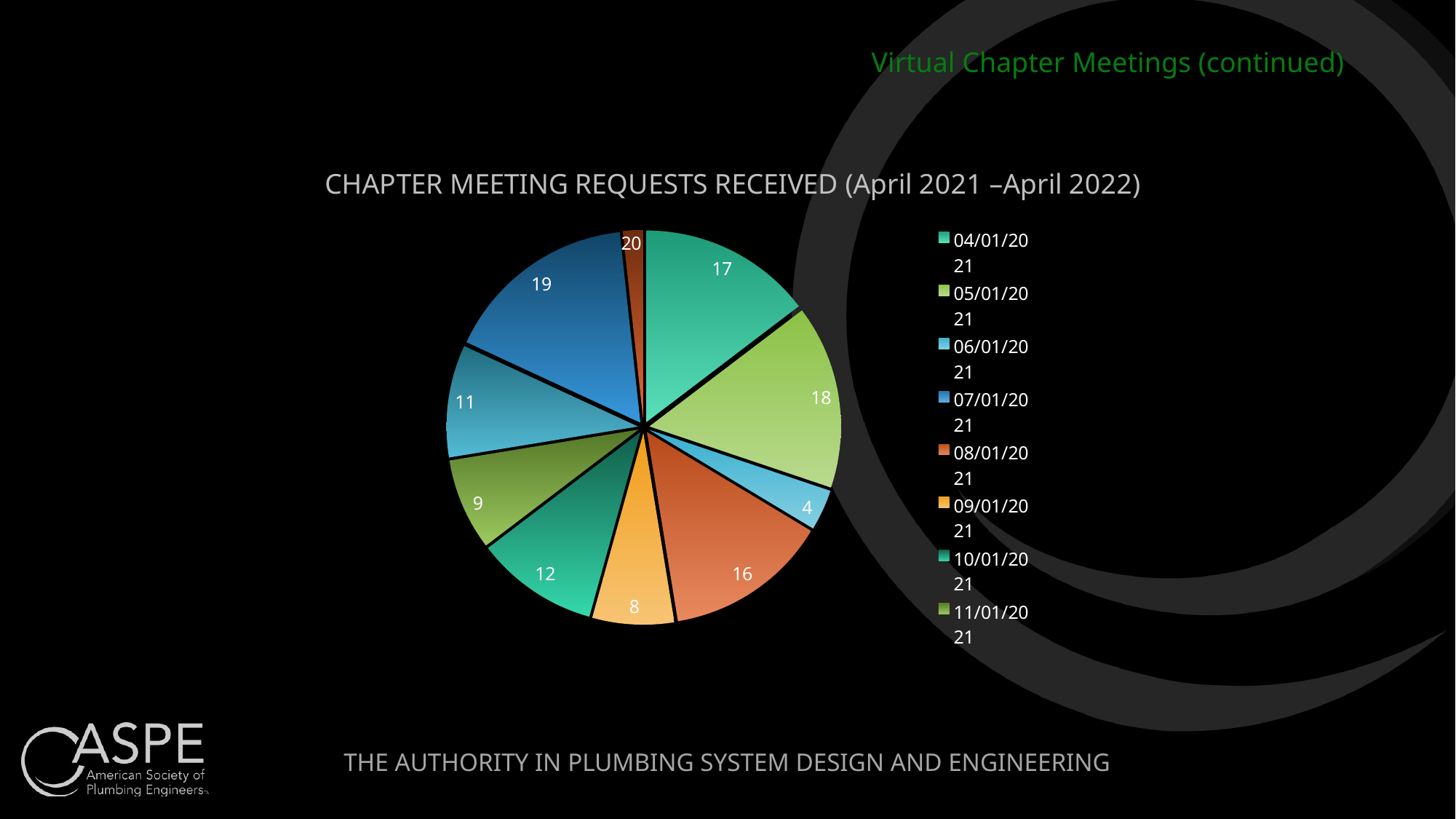
What is the difference between the values for 05/01/2021 and 04/01/2021? 1 How many slices does the pie chart have? 10 What is the value of the slice for 06/01/2021? 4 What is the value of the slice for 05/01/2021? 18 What type of chart is shown on the slide? pie chart What is the value of the slice for 04/01/2021? 17 What is the title of the chart? CHAPTER MEETING REQUESTS RECEIVED (April 2021 –April 2022) Which is larger, the value for 04/01/2021 or the value for 06/01/2021? 04/01/2021 How many entries does the legend list? 8